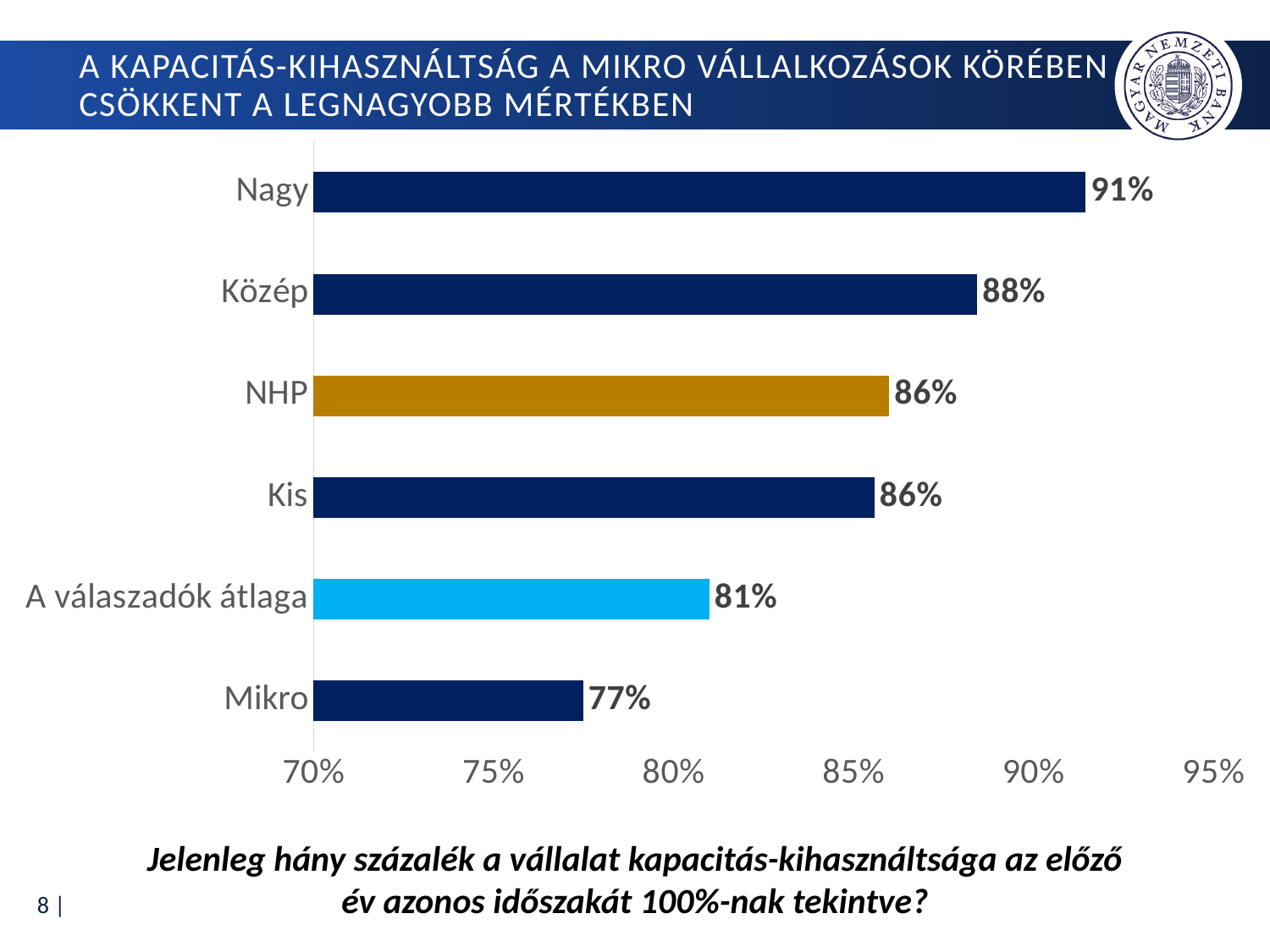
Is the value for Mikro greater or less than 80%? less What kind of chart is shown on the slide? bar chart How many categories are shown in the chart? 6 What is the difference between the values for Nagy and Mikro? 14 percentage points Which category has the lowest value? Mikro Which category has the highest value? Nagy What is the value for Mikro? 77% What is the value for A válaszadók átlaga? 81% What is the value for Közép? 88% Which is larger, the value for Közép or the value for Kis? Közép Which category's bar is coloured gold/orange? NHP What is the value for Nagy? 91%